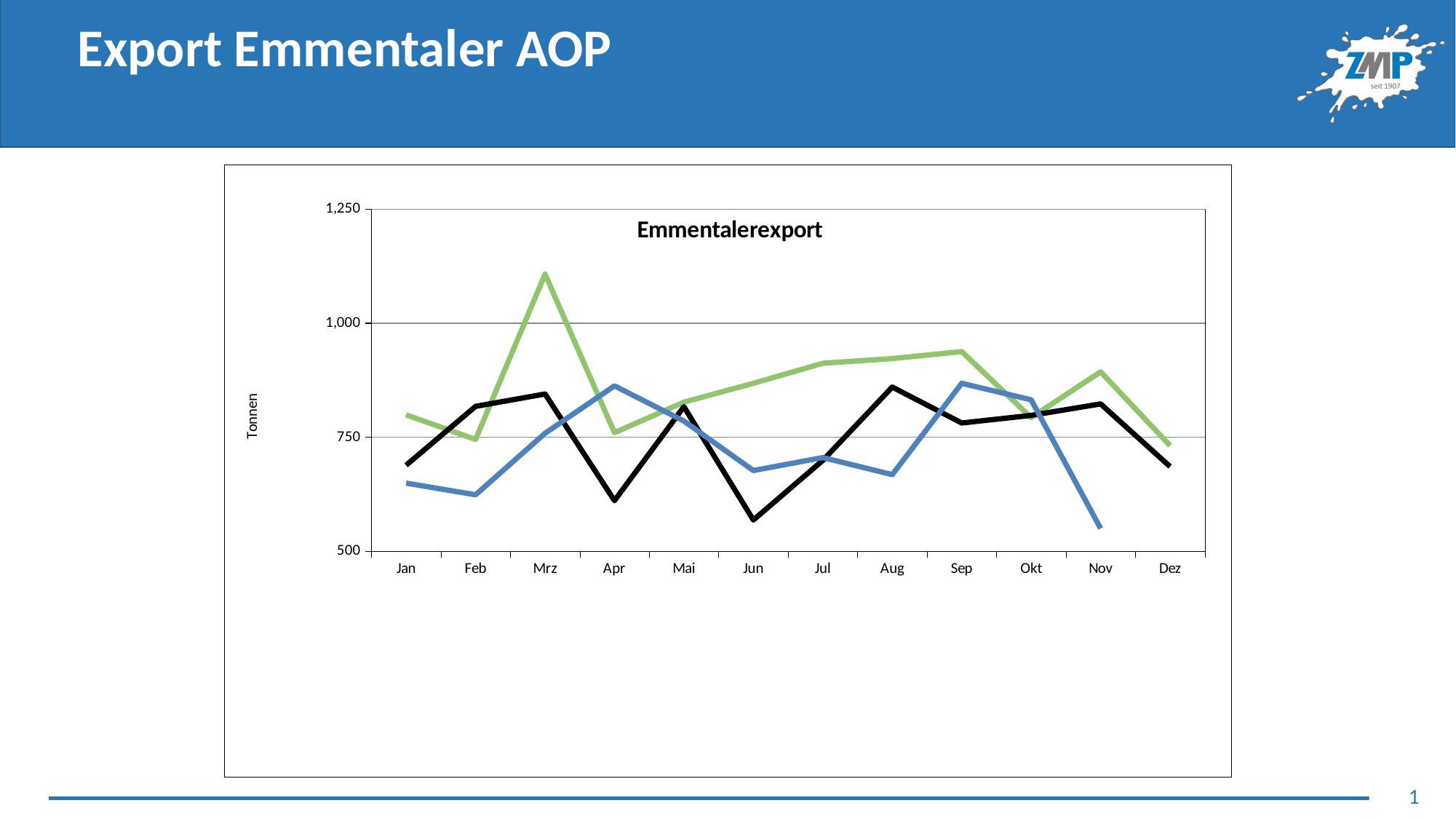
Which line has the higher value in Mrz, the green line or the black line? green line Is the value of the black line in Jun greater or less than 750? less How many lines are plotted in the chart? 3 In which month does the black line reach its lowest value? Jun Does the black line rise or fall from Jan to Mrz? rise In which month does the green line reach its highest value? Mrz Is the value of the green line in Mrz greater or less than 1,000? greater What is the label on the vertical axis of the chart? Tonnen How many months are shown on the x axis of the chart? 12 What is the title of the chart? Emmentalerexport In which month does the blue line reach its lowest value? Nov What kind of chart is shown on the slide? line chart